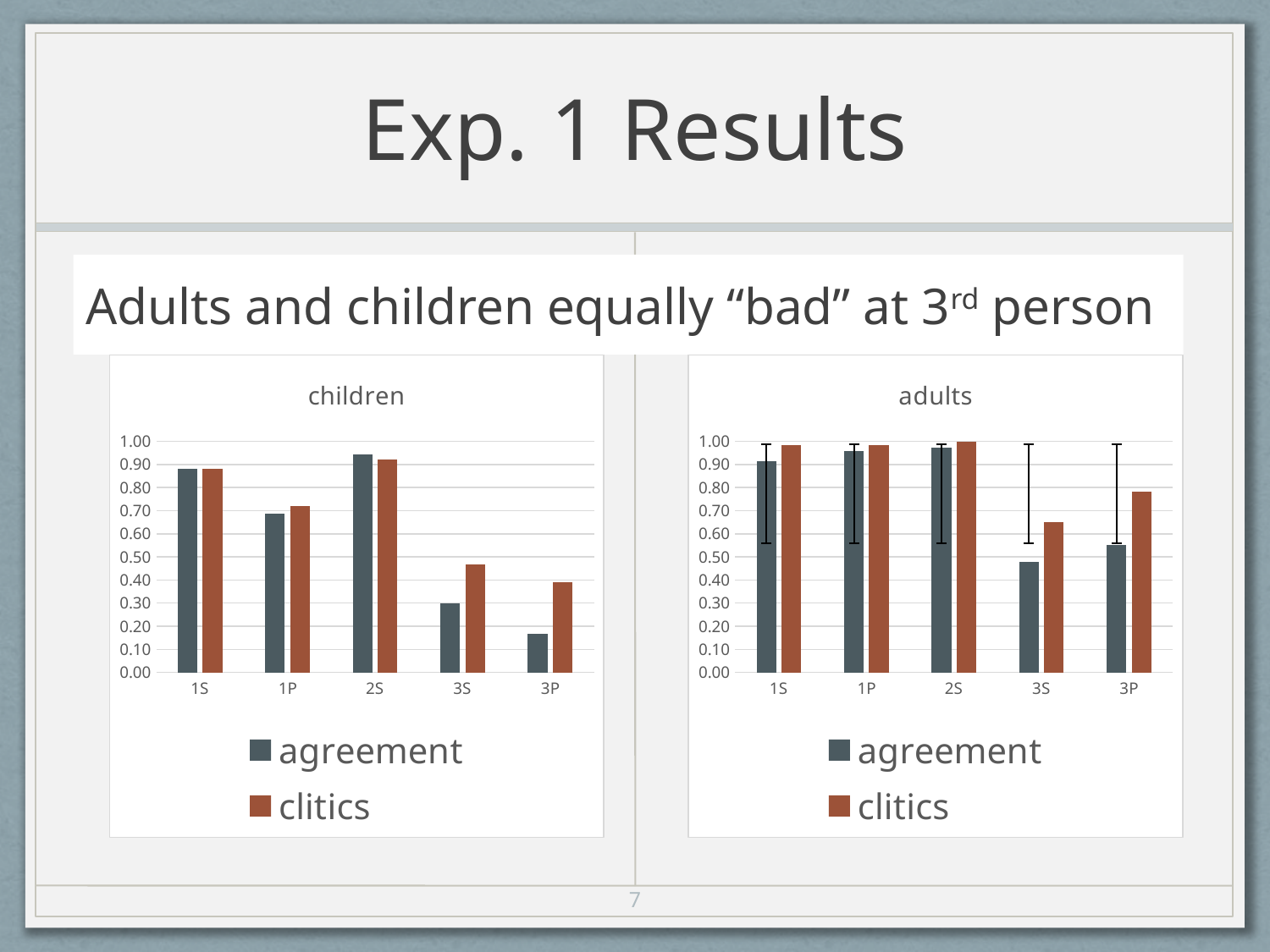
In the "children" chart, is the agreement value for 3S greater or less than 0.40? less How many series does the legend of the "adults" chart list? 2 In the "children" chart, which category has the lowest agreement value? 3P In the "adults" chart, is the agreement value for 3P greater or less than 0.70? less What kind of chart is the "children" chart? bar chart What are the two legend entries in the "children" chart? agreement and clitics In the "children" chart, is the clitics value for 3P greater or less than 0.30? greater In the "adults" chart, which is larger for 3S: agreement or clitics? clitics In the "children" chart, which category has the highest agreement value? 2S How many categories are shown on the x axis of the "children" chart? 5 In the "children" chart, which is larger for 3P: agreement or clitics? clitics In the "adults" chart, which category has the lowest clitics value? 3S